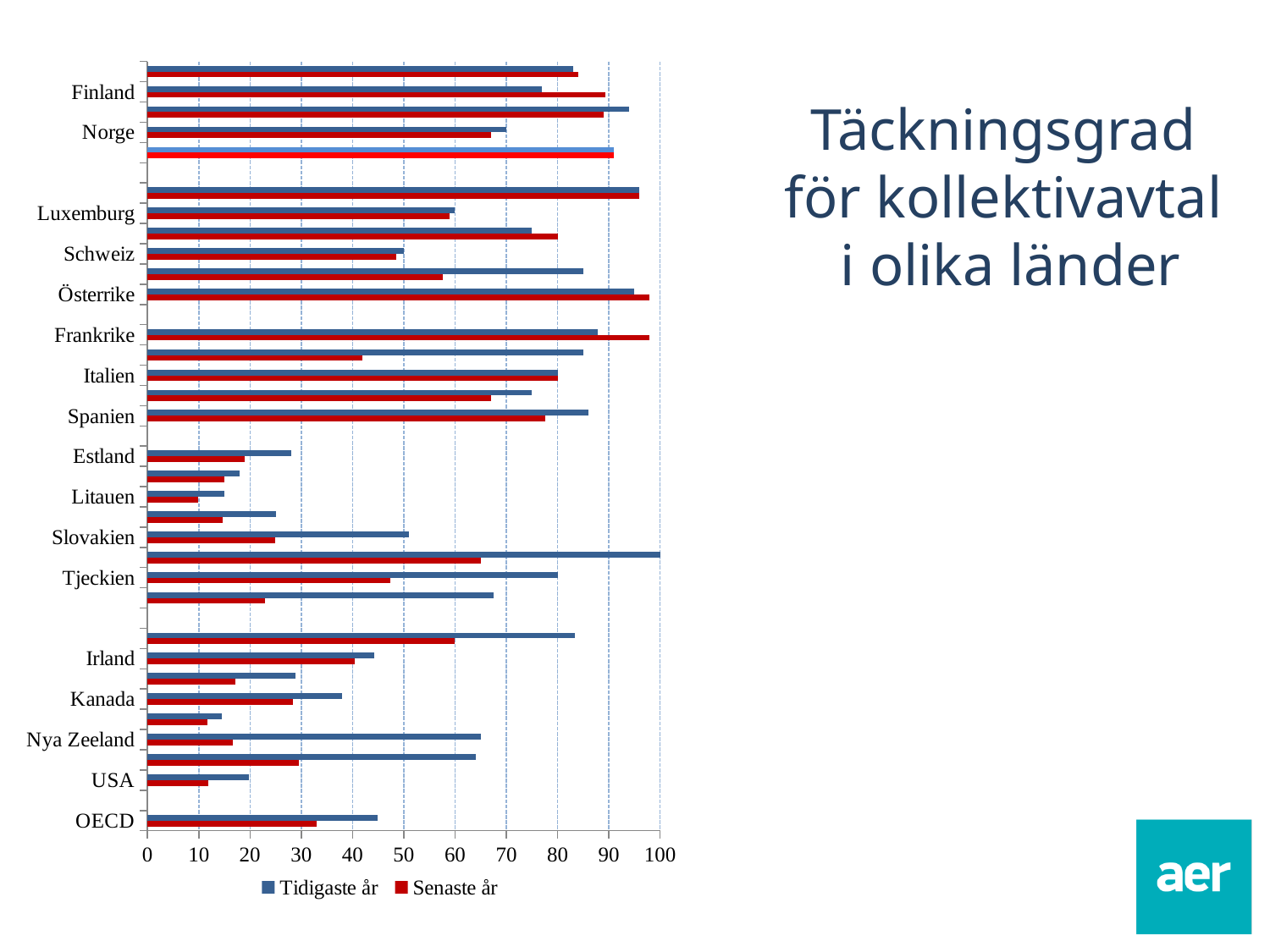
How many series does the legend list? 2 What is the title of the slide's chart? Täckningsgrad för kollektivavtal i olika länder For Nya Zeeland, which series has the larger value, Tidigaste år or Senaste år? Tidigaste år Is the Senaste år value for Frankrike greater or less than 90? greater Is the Tidigaste år value for Tjeckien greater or less than 70? greater Is the Tidigaste år value for Slovakien greater or less than 40? greater What kind of chart is shown on the slide? bar chart For Tjeckien, which series has the larger value, Tidigaste år or Senaste år? Tidigaste år What are the two series named in the legend? Tidigaste år and Senaste år